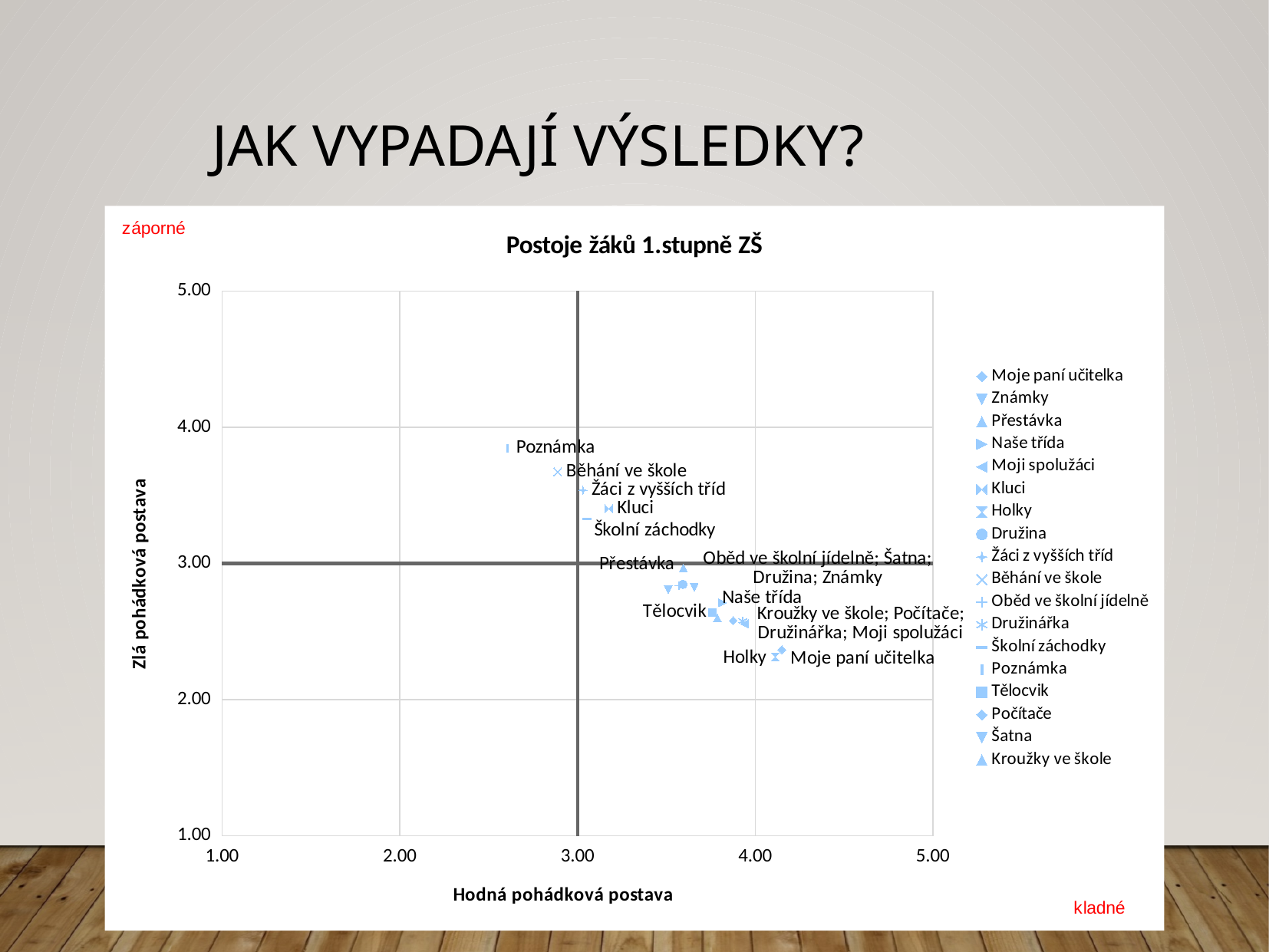
Which has the higher vertical-axis value, Poznámka or Tělocvik? Poznámka Is the vertical-axis value for Moje paní učitelka greater or less than 3.00? less What is the title of the chart? Postoje žáků 1.stupně ZŠ Which has the larger horizontal-axis value, Kluci or Poznámka? Kluci What kind of chart is shown on the slide? scatter chart Is the vertical-axis value for Poznámka greater or less than 3.00? greater How many series does the chart's legend list? 18 What is the label of the horizontal axis of the chart? Hodná pohádková postava Is the horizontal-axis value for Přestávka greater or less than 3.00? greater Which series has the lowest value on the horizontal axis (Hodná pohádková postava)? Poznámka Which series has the highest value on the vertical axis (Zlá pohádková postava)? Poznámka